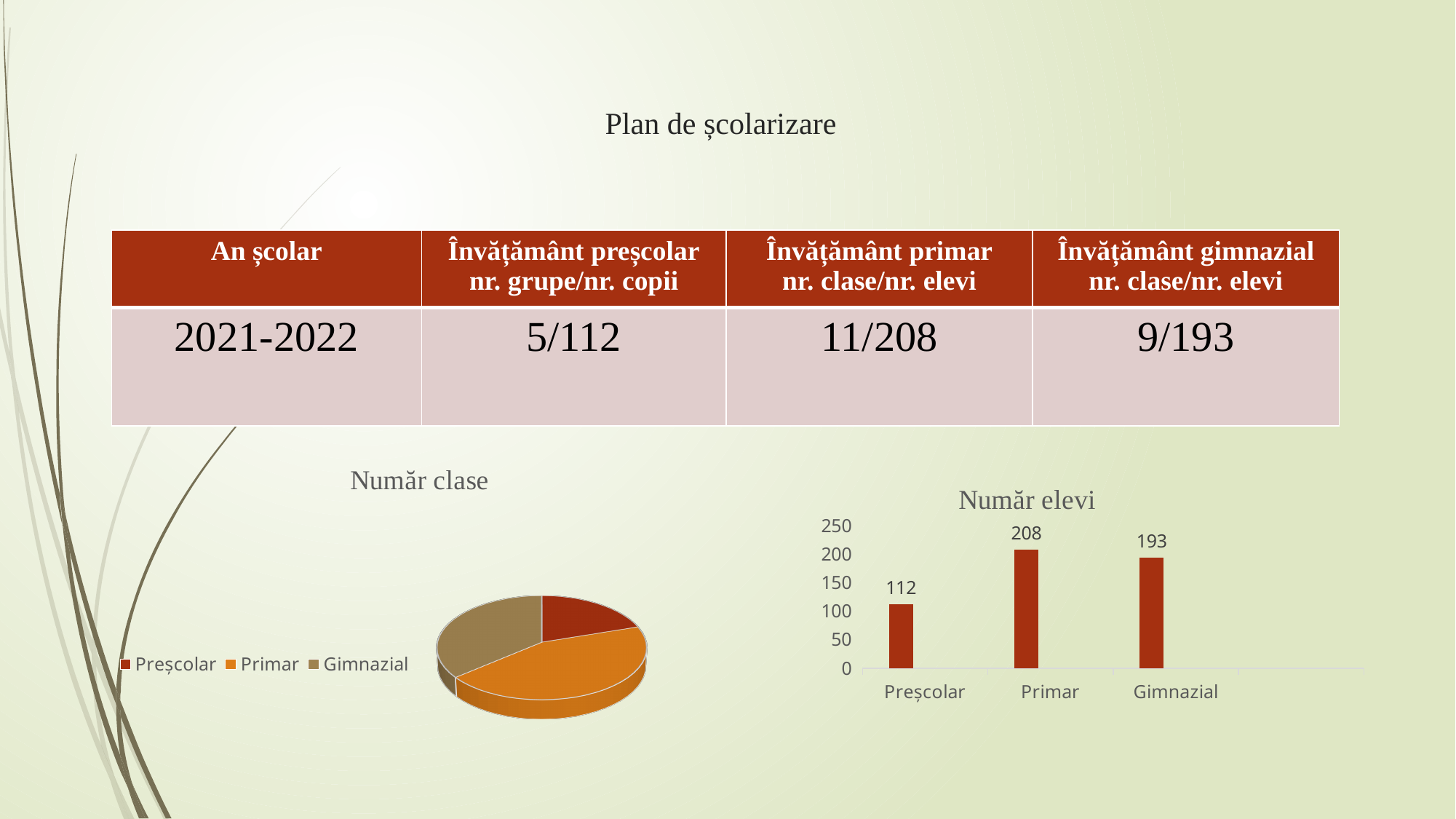
In the 'Număr elevi' chart, what is the value for Preșcolar? 112 What kind of chart is the 'Număr elevi' chart? bar chart In the 'Număr elevi' chart, which category has the highest value? Primar In the 'Număr elevi' chart, which category has the lowest value? Preșcolar How many categories are shown in the 'Număr elevi' chart? 3 In the 'Număr elevi' chart, what is the difference between the values for Primar and Gimnazial? 15 In the 'Număr elevi' chart, what is the value for Primar? 208 In the 'Număr elevi' chart, which is larger, the value for Preșcolar or the value for Gimnazial? Gimnazial In the 'Număr elevi' chart, what is the value for Gimnazial? 193 What kind of chart is the 'Număr clase' chart? pie chart In the 'Număr clase' pie chart, which category has the largest slice? Primar In the 'Număr elevi' chart, is the value for Preșcolar greater or less than 150? less